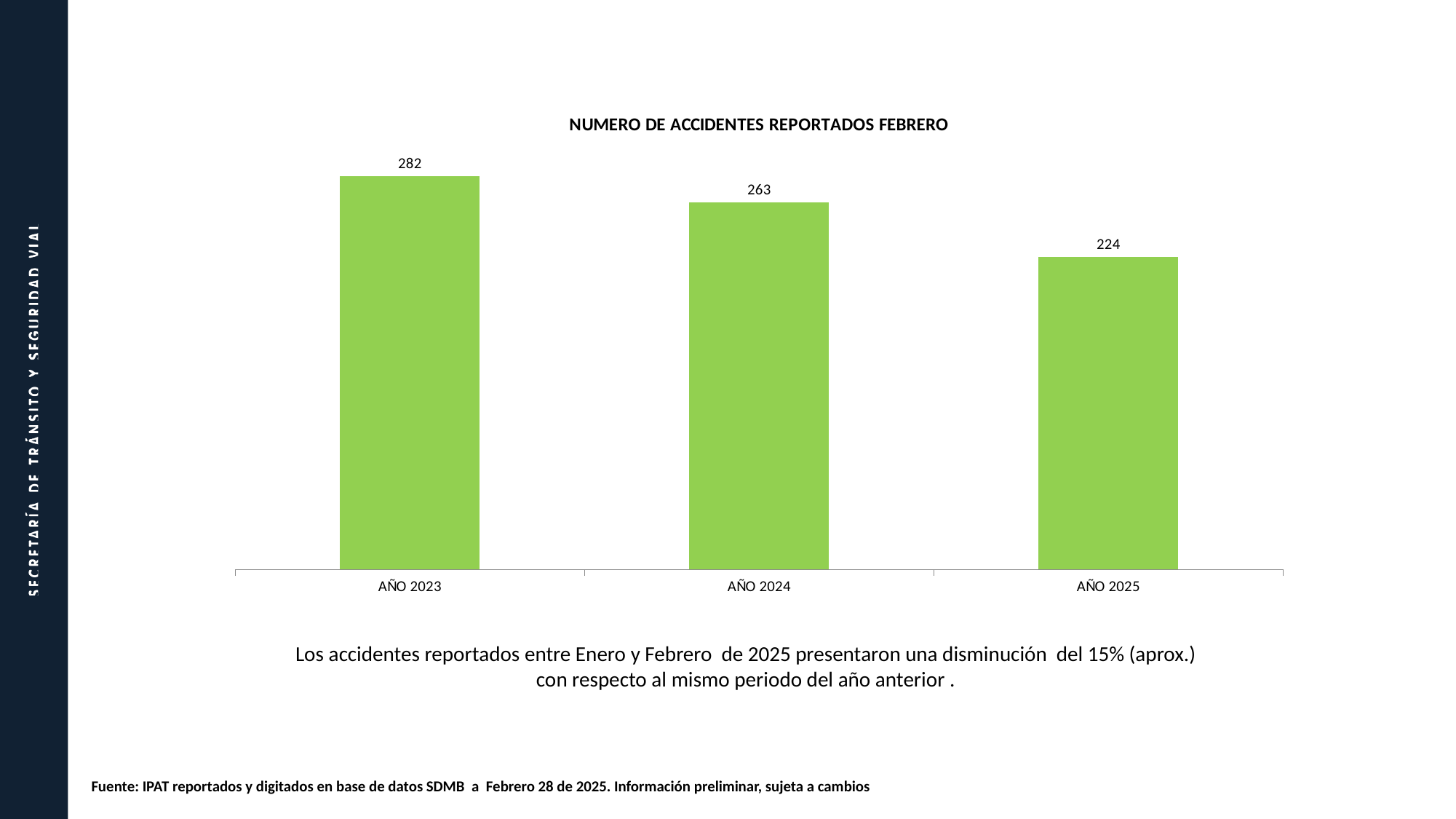
Which is larger, the value for AÑO 2023 or the value for AÑO 2024? AÑO 2023 What is the number of accidents reported for AÑO 2024? 263 What is the number of accidents reported for AÑO 2025? 224 Do the values rise or fall from AÑO 2023 to AÑO 2025? Fall What is the title of the chart? NUMERO DE ACCIDENTES REPORTADOS FEBRERO Which year has the lowest number of accidents reported? AÑO 2025 What is the difference between the values for AÑO 2023 and AÑO 2025? 58 What is the number of accidents reported for AÑO 2023? 282 What kind of chart is shown on the slide? Bar chart What is the difference between the values for AÑO 2024 and AÑO 2025? 39 How many years are shown on the chart? 3 Which year has the highest number of accidents reported? AÑO 2023